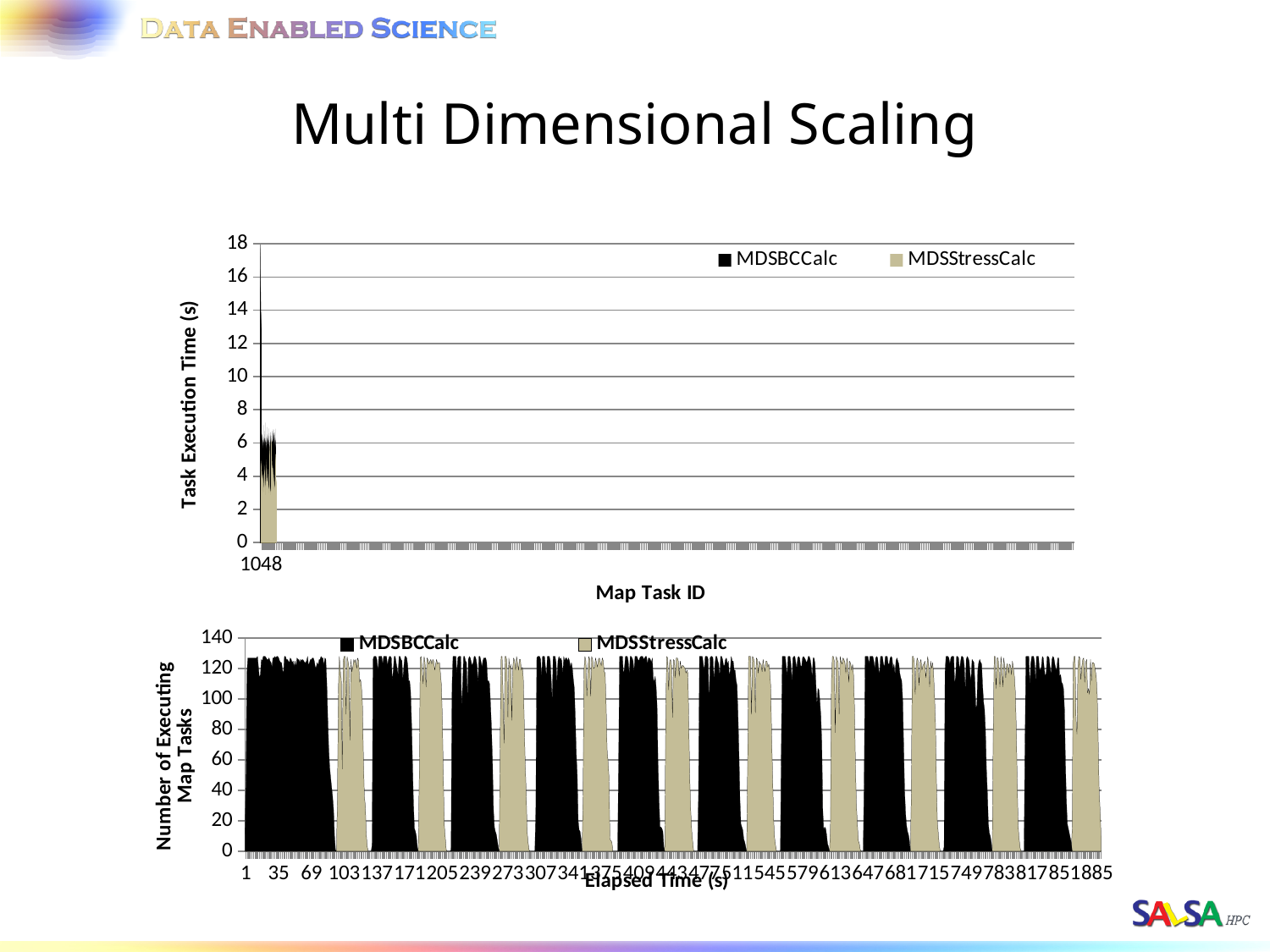
In the bottom chart, are the peak values of the MDSBCCalc series greater or less than 100? greater How many series does the legend of the top chart list? 2 How many series does the legend of the bottom chart list? 2 What are the two series named in the legend of the top chart? MDSBCCalc and MDSStressCalc In the bottom chart, are the peak values of the MDSStressCalc series greater or less than 60? greater What is the highest tick value shown on the y-axis of the bottom chart? 140 What is the x-axis title of the bottom chart? Elapsed Time (s) What is the y-axis title of the top chart? Task Execution Time (s) What is the highest tick value shown on the y-axis of the top chart? 18 What is the first x-axis tick label shown on the bottom chart? 1 What is the last x-axis tick label shown on the bottom chart? 1885